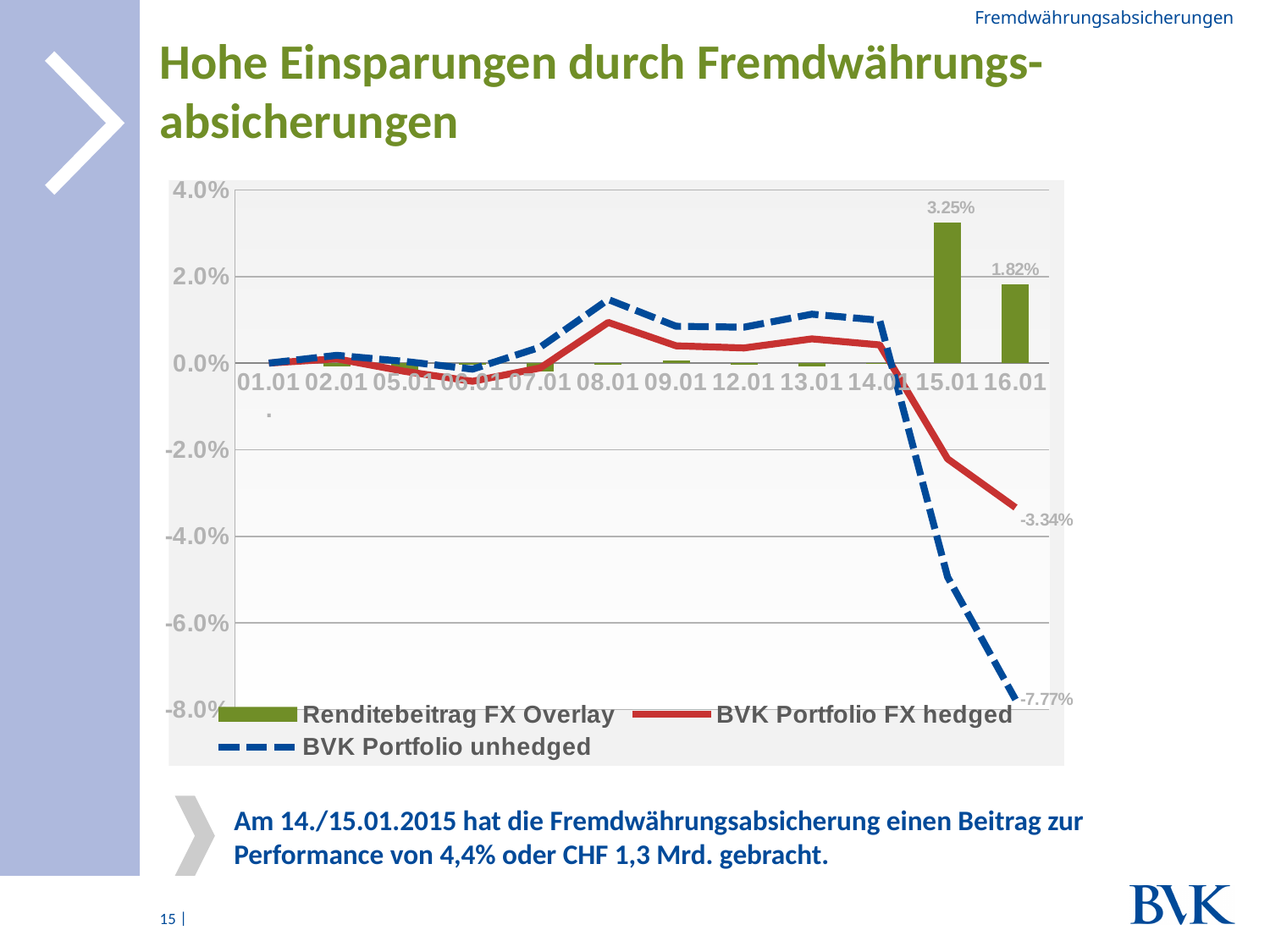
What kind of chart is shown on the slide? A combined bar and line chart Does the BVK Portfolio unhedged line rise or fall from 14.01 to 16.01? It falls What is the value of BVK Portfolio FX hedged at 16.01? -3.34% By how many percentage points does the Renditebeitrag FX Overlay at 15.01 exceed that at 16.01? 1.43 percentage points What is the value of BVK Portfolio unhedged at 16.01? -7.77% Is the value for BVK Portfolio unhedged at 15.01 greater or less than -4.0%? less At 16.01, which is higher: BVK Portfolio FX hedged or BVK Portfolio unhedged? BVK Portfolio FX hedged What is the value of Renditebeitrag FX Overlay at 16.01? 1.82% How many dates are shown on the x axis? 12 How many series does the legend list? 3 At 16.01, what is the difference between BVK Portfolio FX hedged and BVK Portfolio unhedged? 4.43 percentage points What is the value of Renditebeitrag FX Overlay at 15.01? 3.25%